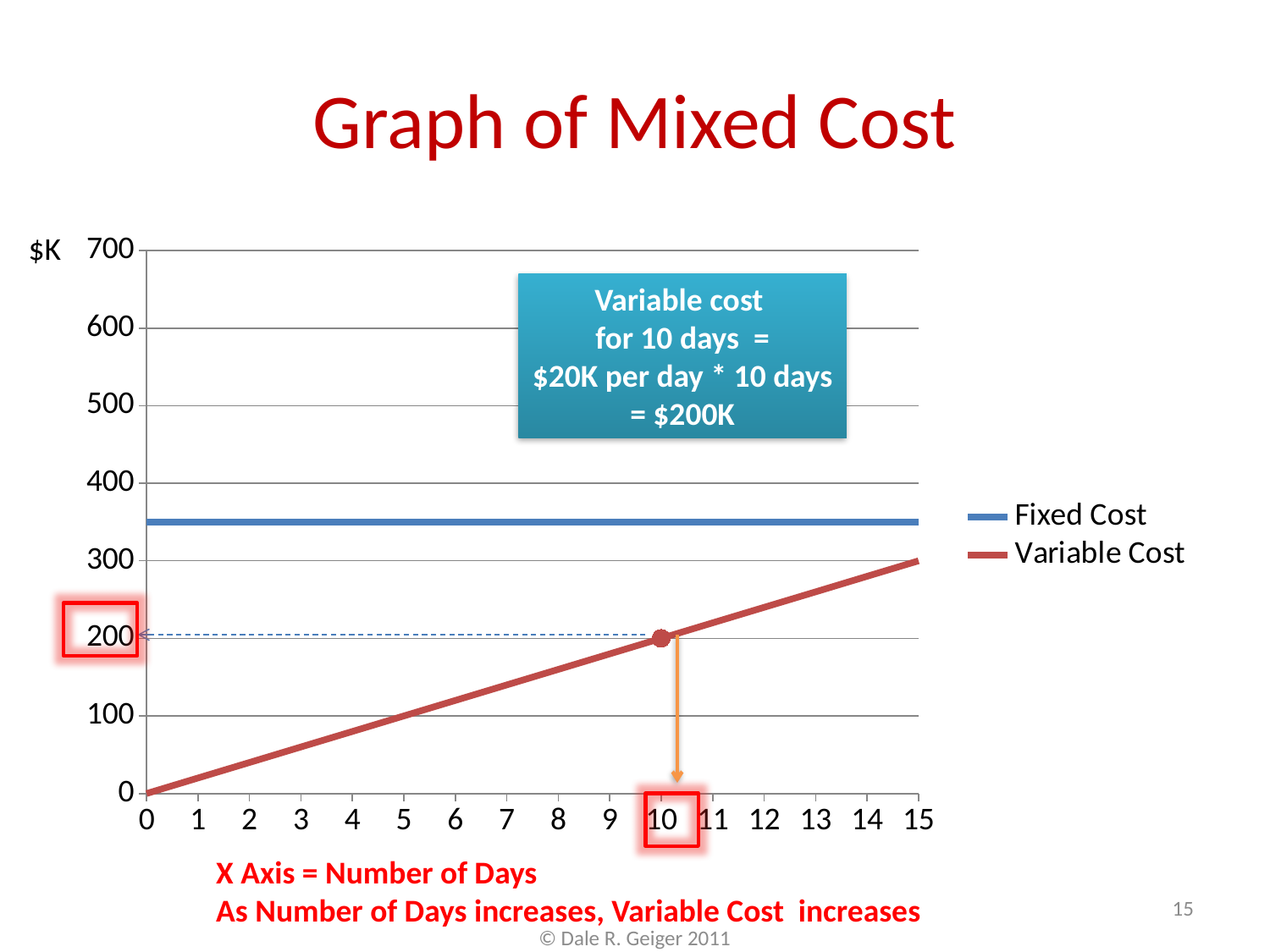
Which series is drawn in blue? Fixed Cost What is the Variable Cost at 10 days? $200K Is the Fixed Cost greater or less than 300? greater What is the title of the chart? Graph of Mixed Cost What is the Variable Cost at 0 days? 0 What is the difference between the Variable Cost at 15 days and at 10 days? 100 What is the Variable Cost at 15 days? 300 How many series does the legend list? 2 Does the Variable Cost rise or fall as the number of days increases? rises At 5 days, which is larger, Fixed Cost or Variable Cost? Fixed Cost Is the Fixed Cost greater or less than 400? less What kind of chart is shown on the slide? line chart